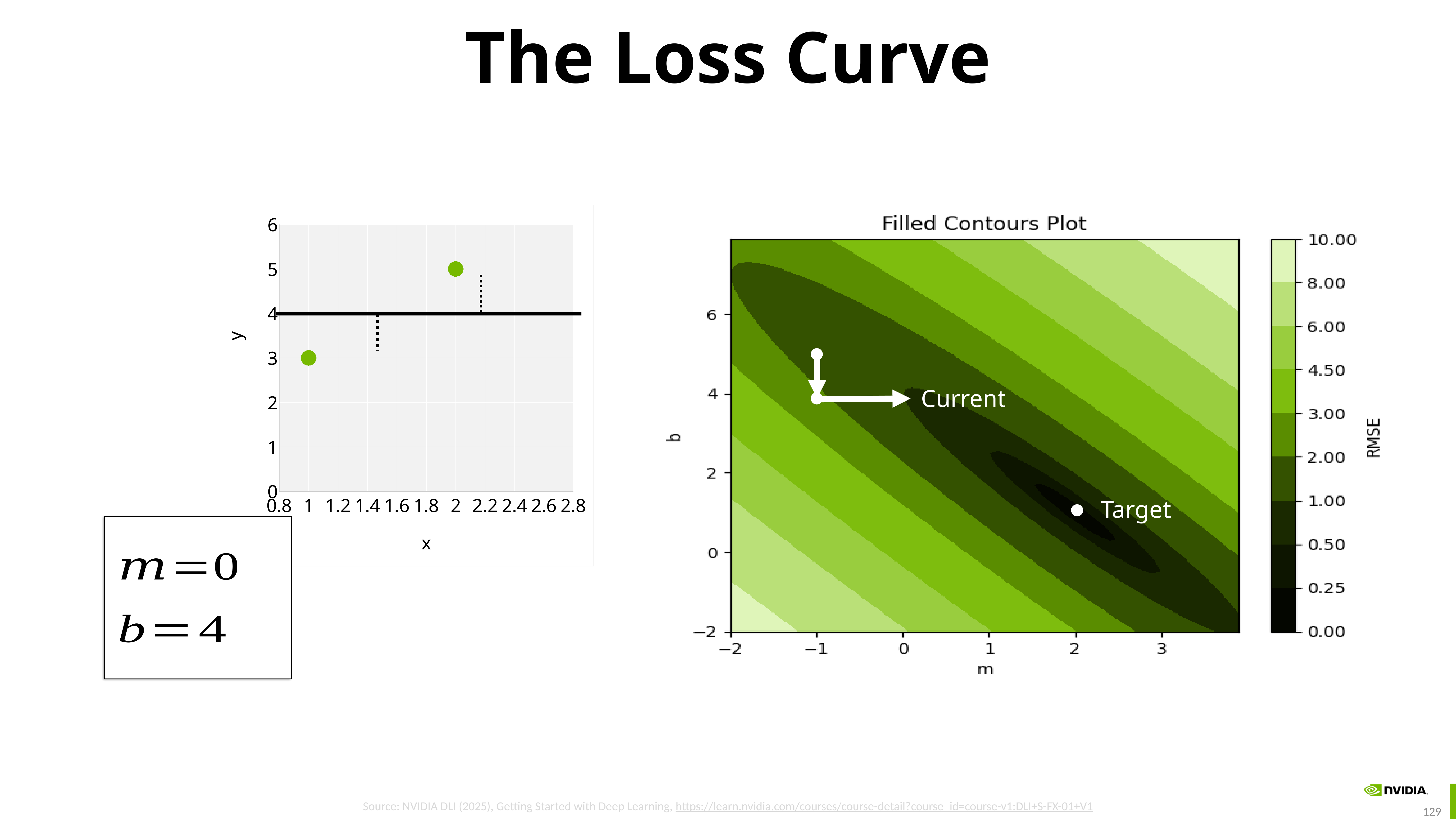
On the left chart, at what y value does the solid horizontal line sit? 4 On the Filled Contours Plot, what is the maximum value shown on the RMSE colour bar? 10.00 On the left chart, what is the y value of the data point at x = 2? 5 On the left chart, which data point has the higher y value, the one at x = 1 or the one at x = 2? x = 2 On the left chart, what is the difference in y between the point at x = 2 and the point at x = 1? 2 On the Filled Contours Plot, what is the m value of the point labelled Target? 2 On the Filled Contours Plot, what quantity does the colour bar represent? RMSE What is the title of the chart on the right? Filled Contours Plot On the left chart, do the plotted y values rise or fall as x increases? rise On the left chart, what is the y value of the data point at x = 1? 3 On the left chart, how many green data points are plotted? 2 On the Filled Contours Plot, what is the minimum value shown on the RMSE colour bar? 0.00